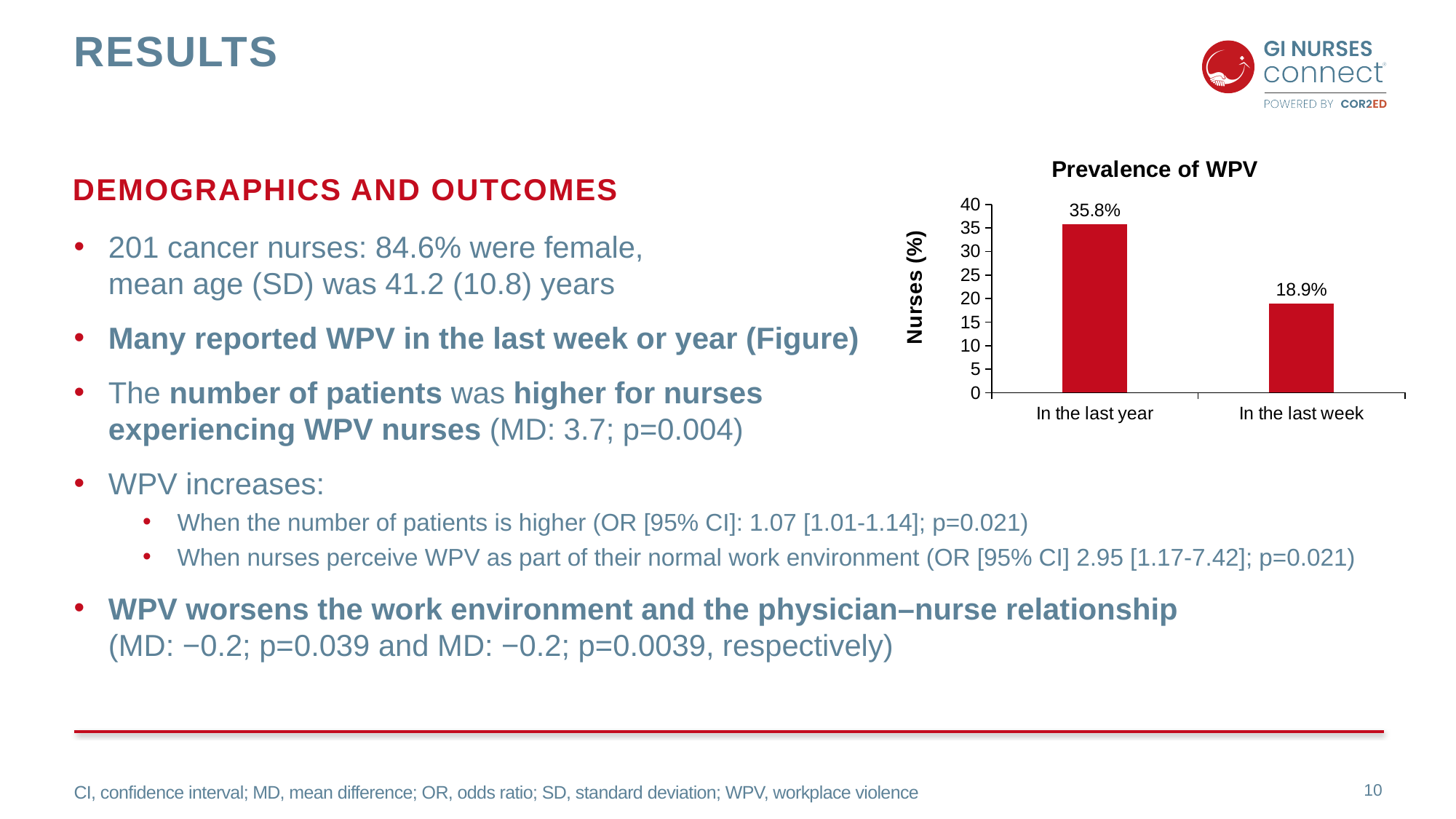
Which category has the lowest value in the Prevalence of WPV chart? In the last week Which is larger in the Prevalence of WPV chart: 'In the last year' or 'In the last week'? In the last year Which category has the highest value in the Prevalence of WPV chart? In the last year What is the title of the chart on the slide? Prevalence of WPV What kind of chart is the Prevalence of WPV chart? Bar chart What is the y-axis label of the Prevalence of WPV chart? Nurses (%) What is the value for 'In the last week' in the Prevalence of WPV chart? 18.9% What is the value for 'In the last year' in the Prevalence of WPV chart? 35.8% How many categories are shown in the Prevalence of WPV chart? 2 Is the value for 'In the last week' greater or less than 20 in the Prevalence of WPV chart? less What is the difference between the 'In the last year' and 'In the last week' values in the Prevalence of WPV chart? 16.9% Is the value for 'In the last year' greater or less than 30 in the Prevalence of WPV chart? greater